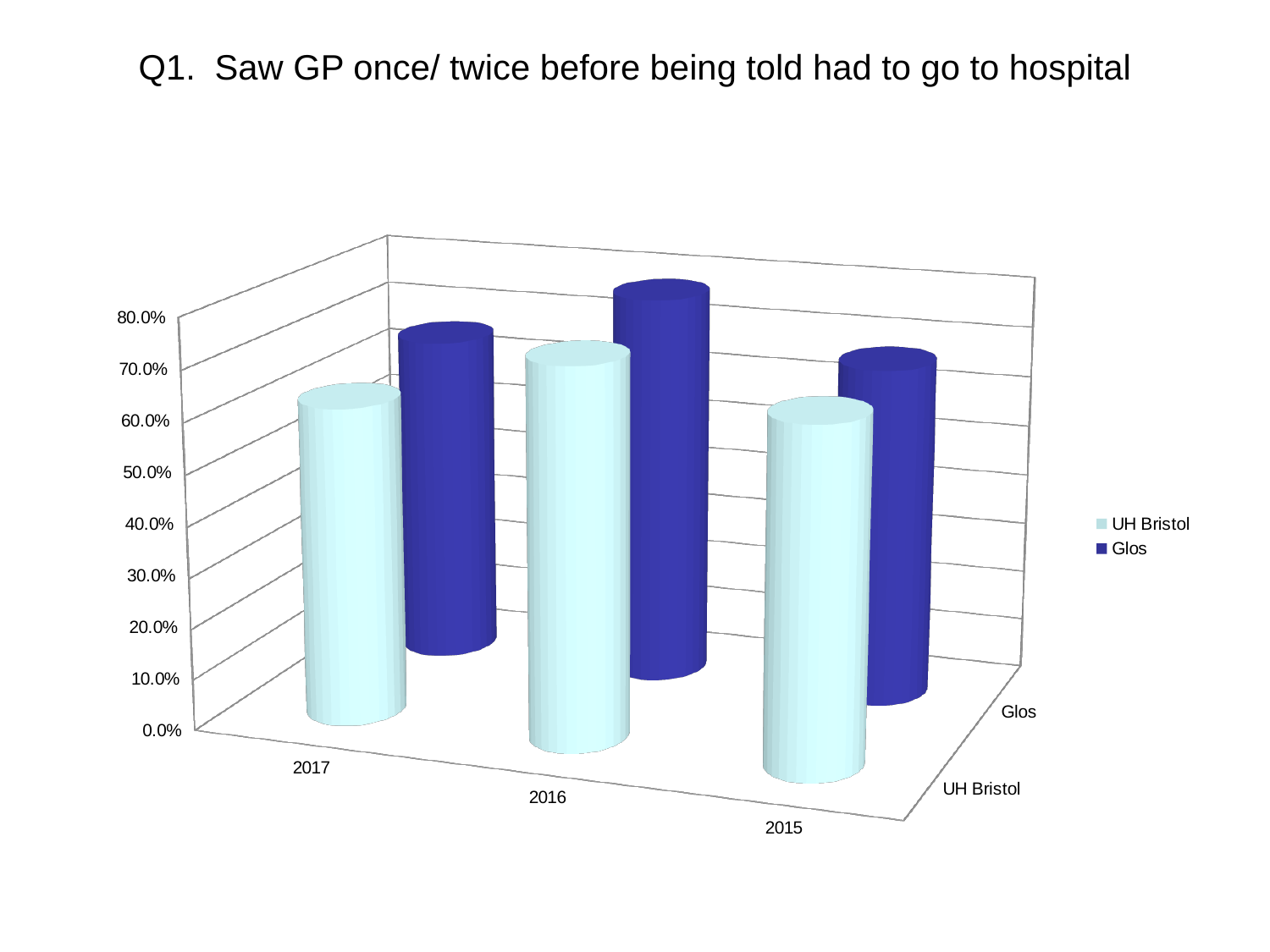
For the Glos series, which is larger: the value for 2016 or the value for 2017? 2016 For the Glos series, which year has the highest value? 2016 What kind of chart is shown on the slide? bar chart For the UH Bristol series, which year has the lowest value? 2017 Is the Glos value for 2016 greater or less than 50.0%? greater For the UH Bristol series, which year has the highest value? 2016 Along the x axis from 2017 to 2015, does the UH Bristol value rise steadily, fall steadily, or rise then fall? rise then fall How many series does the legend list? 2 Is the UH Bristol value for 2017 greater or less than 40.0%? greater How many year categories are plotted along the x axis? 3 What is the title of the chart? Q1. Saw GP once/ twice before being told had to go to hospital Which series is shown in dark blue according to the legend? Glos